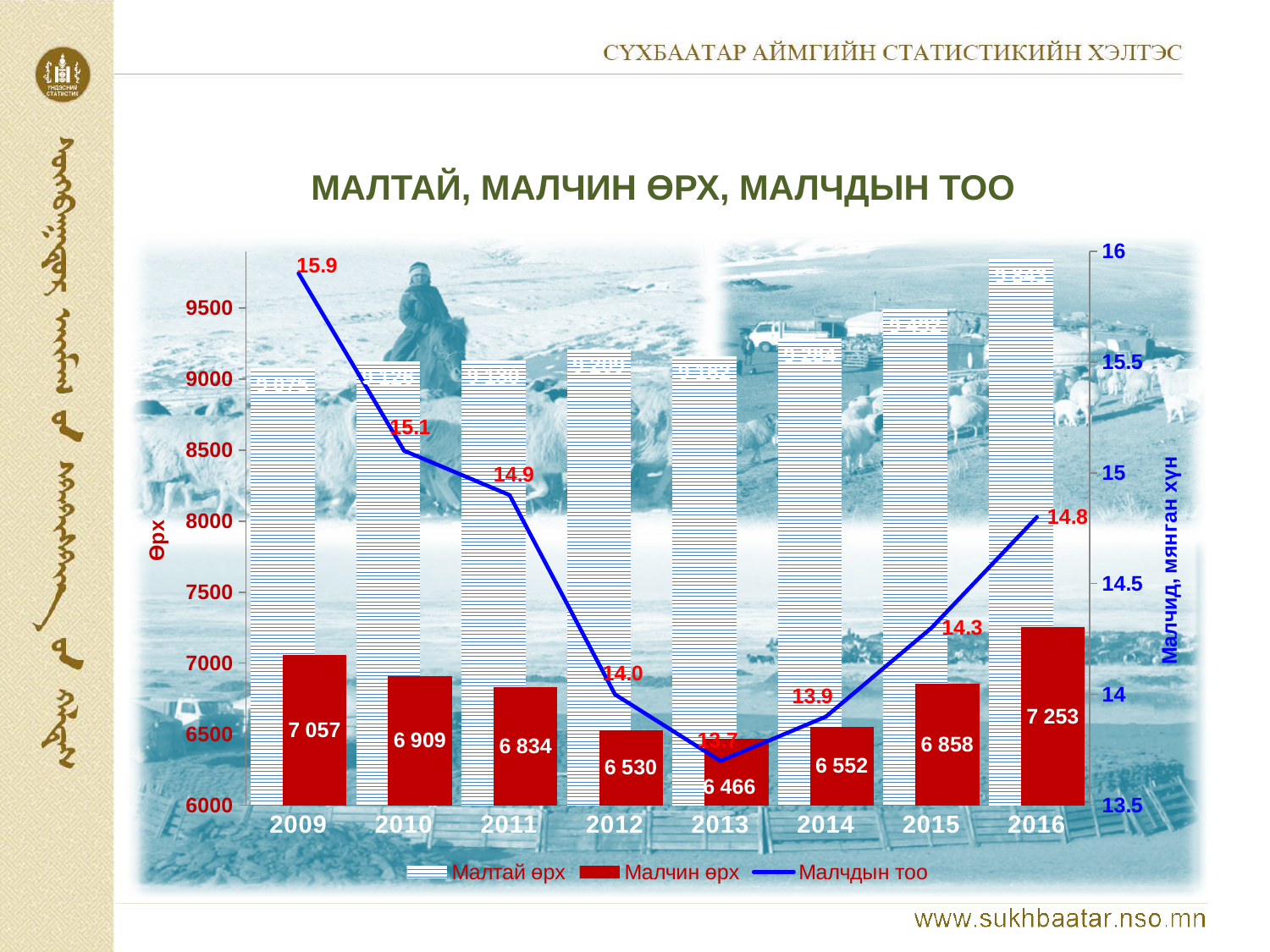
In which year is Малчин өрх lowest? 2013 Which year has the larger Малчин өрх value, 2010 or 2015? 2010 In which year is Малчин өрх highest? 2016 What is the value of Малчдын тоо for 2016? 14.8 How many years are shown on the x axis? 8 What is the value of Малчин өрх for 2009? 7 057 Does Малчдын тоо rise or fall from 2009 to 2013? fall Is the value of Малтай өрх for 2016 greater or less than 9500? greater What is the value of Малчин өрх for 2016? 7 253 What is the difference between Малчин өрх in 2016 and in 2009? 196 What is the value of Малчдын тоо for 2009? 15.9 How many series does the legend list? 3